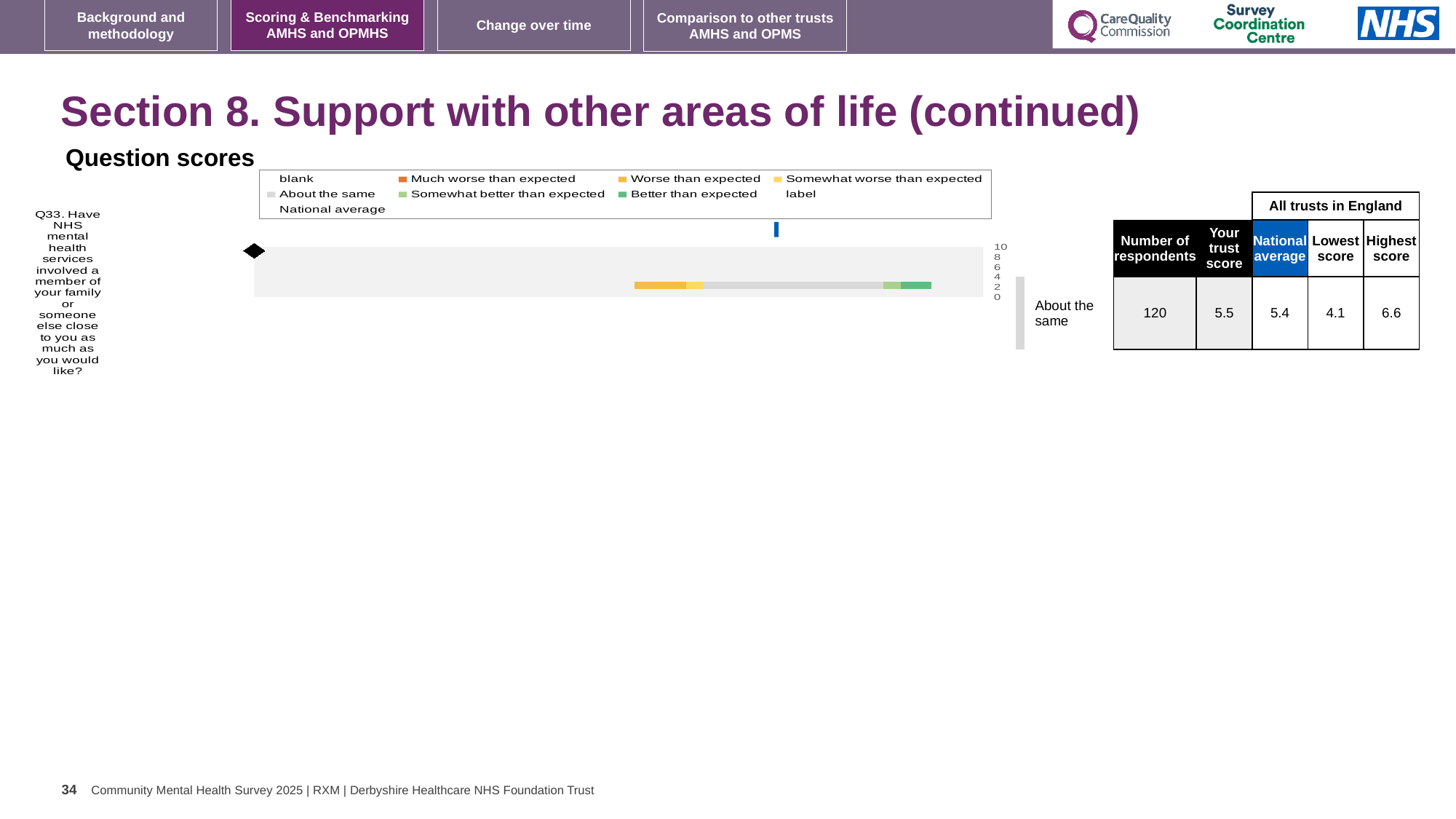
What benchmark category is shown to the right of the chart for Q33? About the same How many entries does the chart legend list? 9 What is the lowest score among all trusts in England for Q33? 4.1 What kind of chart is shown under 'Question scores'? bar chart What is the difference between the highest and lowest scores among all trusts in England for Q33? 2.5 What is the number of respondents for Q33? 120 Is the trust's score for Q33 higher or lower than the national average? higher What is the trust's score for Q33? 5.5 What is the highest score among all trusts in England for Q33? 6.6 How many questions (categories) are plotted in the chart? 1 What is the national average score for Q33? 5.4 Which question number is plotted in the chart? Q33